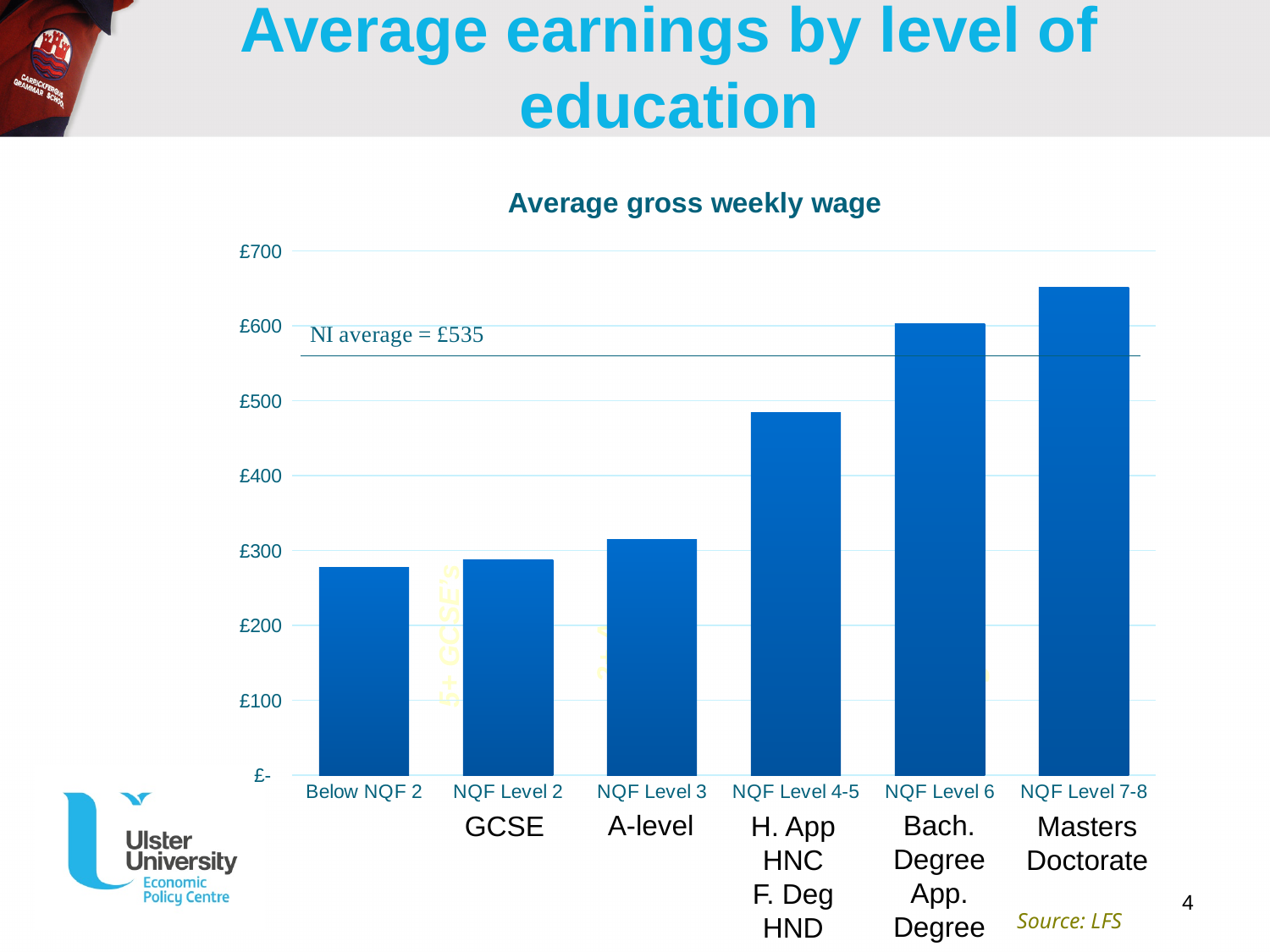
What kind of chart is shown on the slide? bar chart How many education levels (bars) are plotted in the chart? 6 Is the value for NQF Level 4-5 greater or less than £500? less What NI average value is marked by the horizontal line on the chart? £535 Is the value for NQF Level 3 greater or less than £300? greater Which is larger, the value for NQF Level 3 or the value for NQF Level 4-5? NQF Level 4-5 Is the value for Below NQF 2 greater or less than £300? less Do the values rise or fall as the level of education increases from left to right? rise Which education level has the highest average gross weekly wage? NQF Level 7-8 What is the title of the chart? Average gross weekly wage